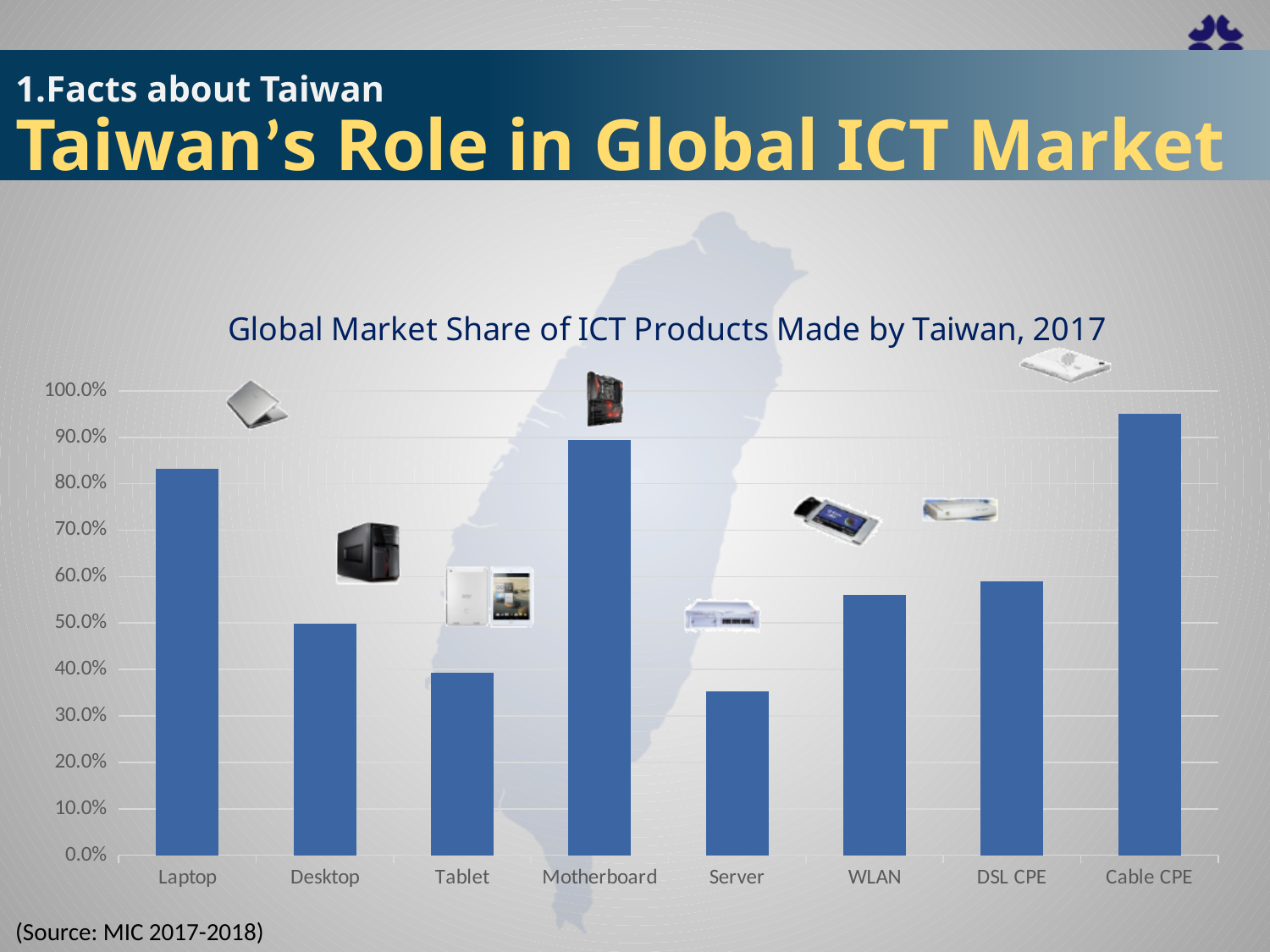
Is the value for Laptop greater or less than 80.0%? greater Which product category has the lowest global market share in the chart? Server Is the value for Motherboard greater or less than 80.0%? greater What type of chart is shown on the slide? bar chart Is the value for Cable CPE greater or less than 90.0%? greater Which has a larger global market share, Motherboard or Cable CPE? Cable CPE What is the title of the chart? Global Market Share of ICT Products Made by Taiwan, 2017 Which has a larger global market share, Laptop or Desktop? Laptop How many product categories are shown on the x axis of the chart? 8 Which product category has the highest global market share in the chart? Cable CPE